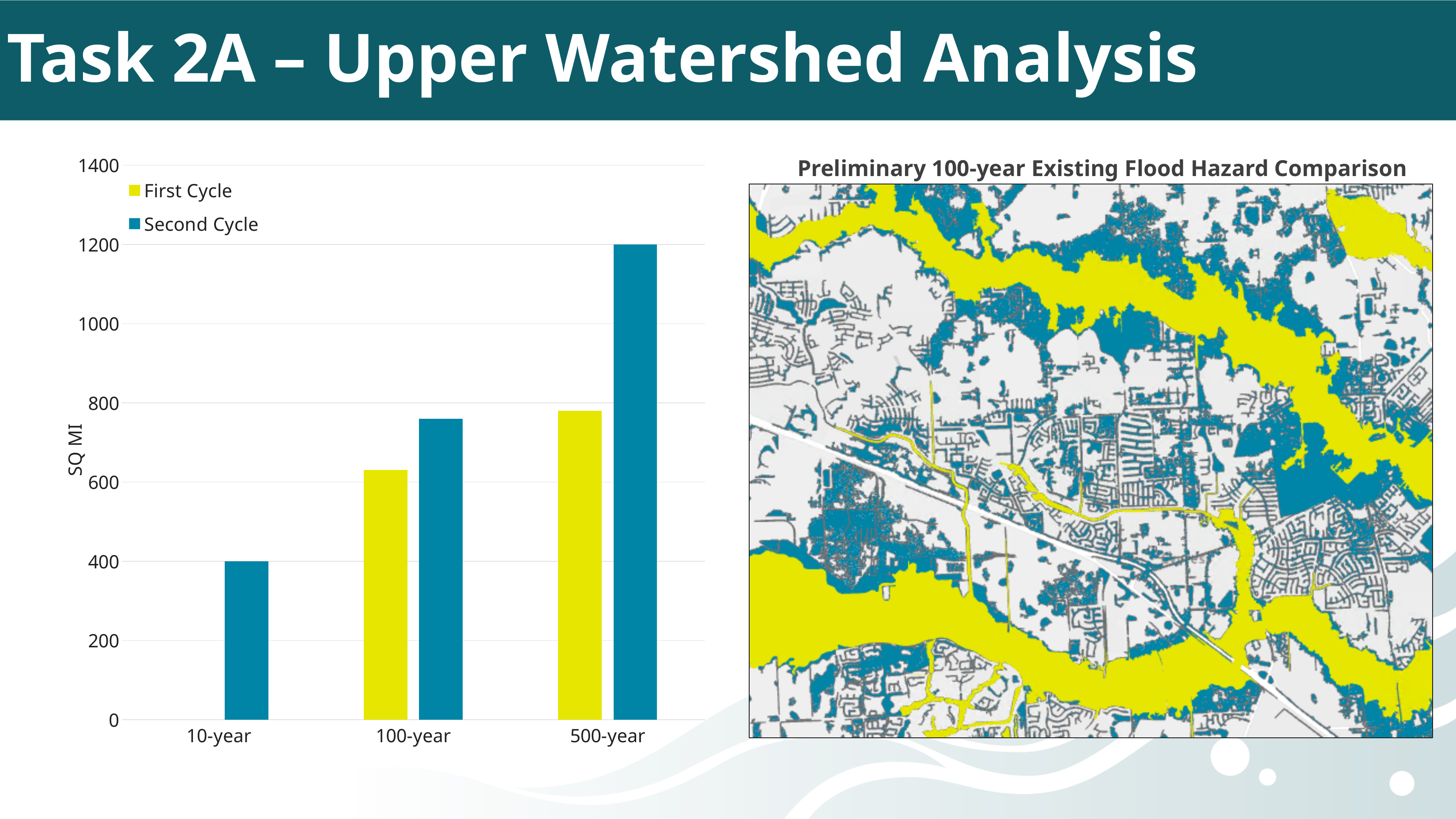
How many categories are shown on the x axis of the bar chart? 3 Is the Second Cycle value for 100-year greater or less than 800? less For 500-year, which is larger: First Cycle or Second Cycle? Second Cycle Do the Second Cycle values rise or fall from 10-year to 500-year? rise Is the First Cycle value for 100-year greater or less than 600? greater Which category has the highest Second Cycle value? 500-year Which category has the lowest Second Cycle value? 10-year What is the Second Cycle value for 500-year? 1200 What is the Second Cycle value for 10-year? 400 What kind of chart is shown on the left of the slide? bar chart What is the difference between the Second Cycle values for 500-year and 10-year? 800 How many series does the legend of the bar chart list? 2